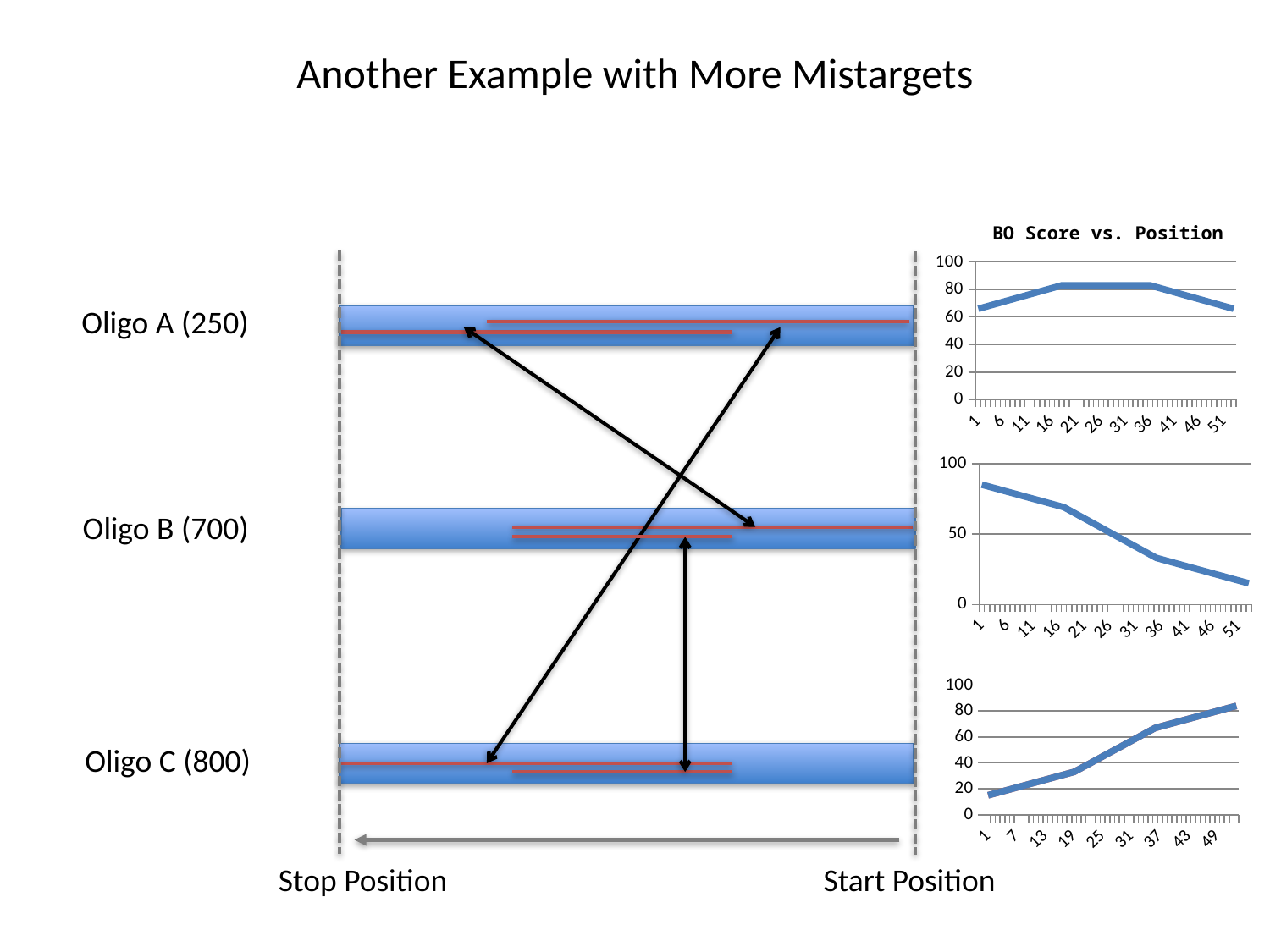
In the bottom-right chart, is the value at position 49 greater or less than 60? greater In the bottom-right chart, do the values rise or fall along the x axis? rise In the middle-right chart, which is larger: the value at position 1 or the value at position 51? position 1 What kind of chart is the top-right chart titled "BO Score vs. Position"? line chart In the middle-right chart, is the value at position 1 greater or less than 50? greater In the middle-right chart, do the values rise or fall along the x axis? fall What is the title of the top-right chart? BO Score vs. Position In the top-right chart (BO Score vs. Position), does the line rise, fall, or rise and then fall along the x axis? rises and then falls In the middle-right chart, is the value at position 51 greater or less than 50? less How many charts are shown on the right side of the slide? 3